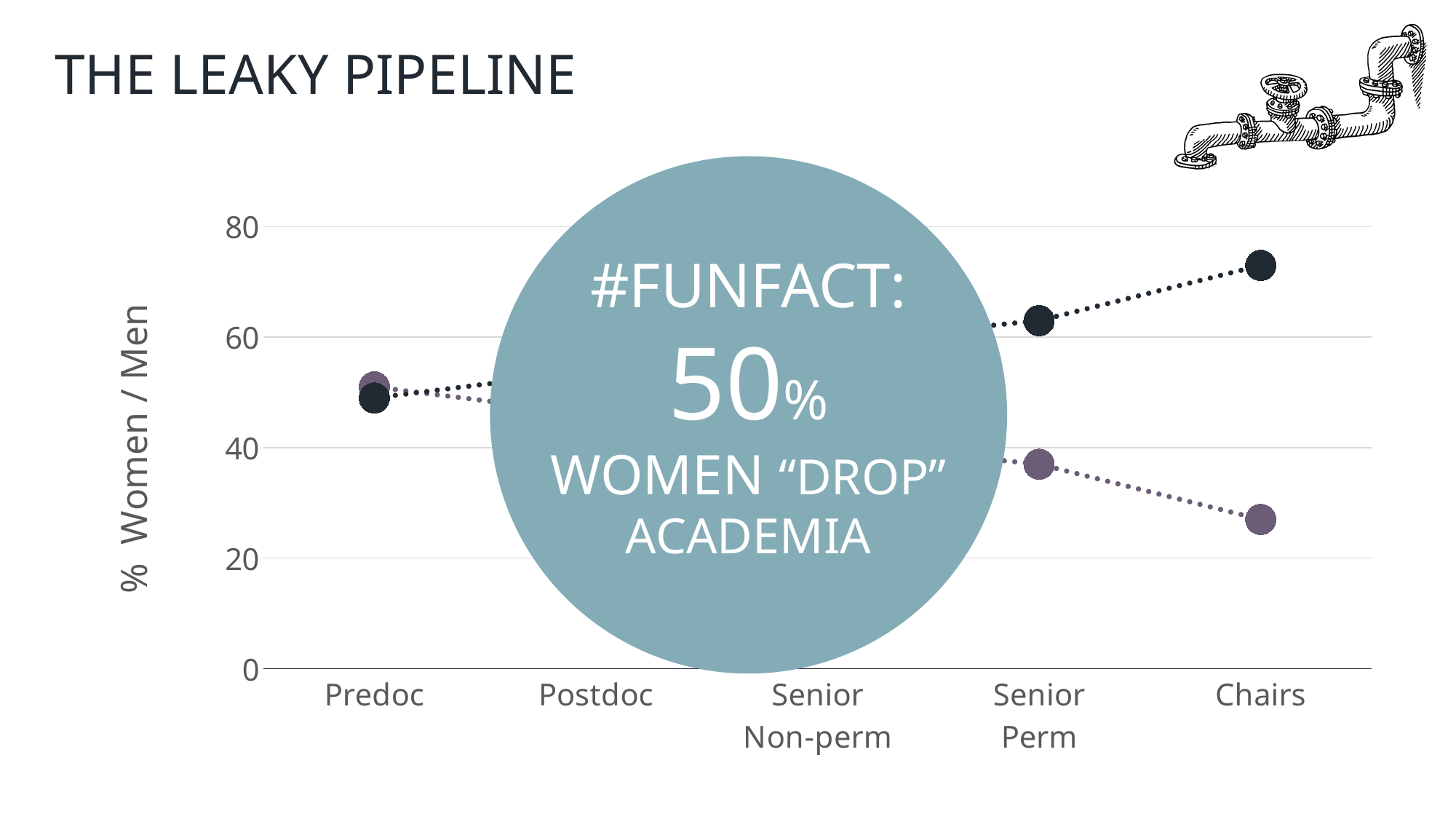
Does the dark line rise or fall from Predoc to Chairs? Rises Is the value of the dark line at Predoc greater or less than 40? greater At Chairs, which line has the higher value, the dark line or the purple line? The dark line What is the title of the slide containing the chart? THE LEAKY PIPELINE Is the value of the purple line at Senior Perm greater or less than 40? less What is the label on the vertical axis of the chart? % Women / Men Does the purple line rise or fall from Predoc to Chairs? Falls Is the value of the purple line at Chairs greater or less than 40? less What kind of chart is shown on the slide? Line chart How many categories are shown on the x axis of the chart? 5